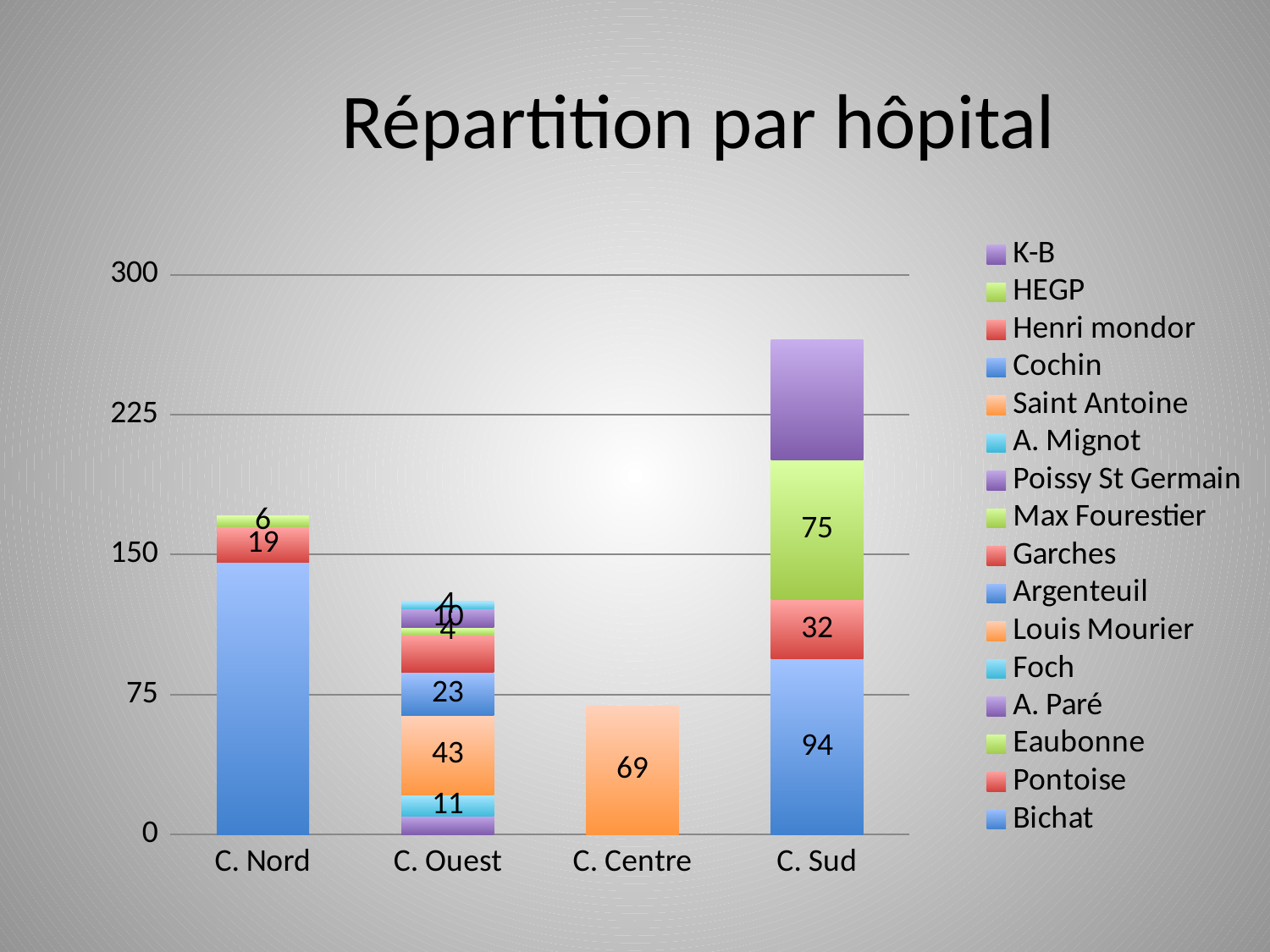
How many series does the legend list? 16 What kind of chart is shown on the slide? Stacked bar chart What value is labelled on the bottom blue segment of the C. Sud bar? 94 Which category has the tallest stacked bar? C. Sud How many categories are shown on the x axis? 4 In the C. Sud bar, what is the difference between the blue segment (94) and the green segment (75)? 19 What is the title of the chart? Répartition par hôpital Which stacked bar is taller, C. Nord or C. Ouest? C. Nord What value is labelled on the orange segment of the C. Ouest bar? 43 What value is labelled on the single orange segment of the C. Centre bar? 69 Which category has the shortest stacked bar? C. Centre Is the total height of the C. Sud bar greater or less than 225? greater